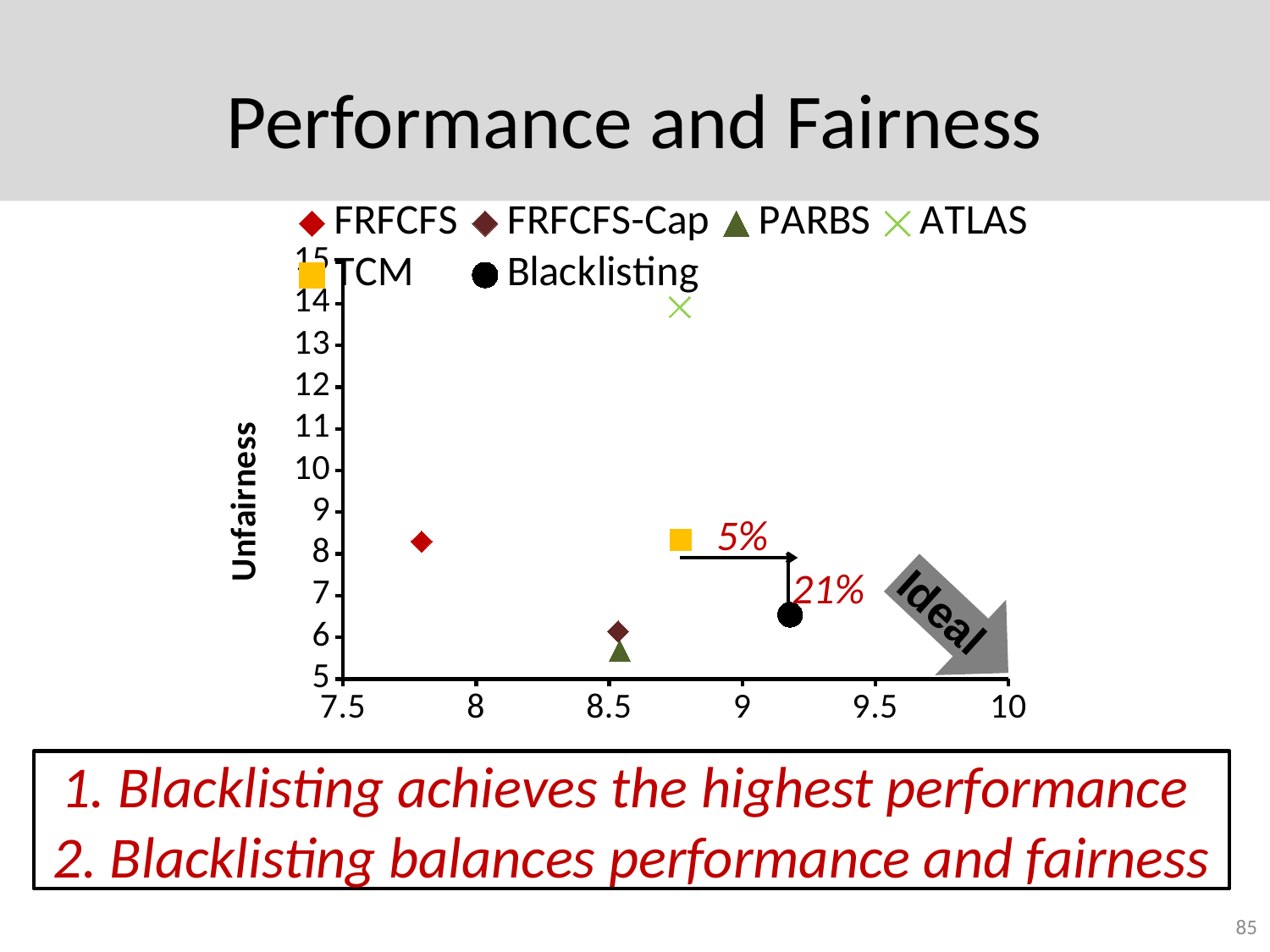
Which series is plotted furthest to the right on the x axis? Blacklisting Which has the higher unfairness value, ATLAS or TCM? ATLAS What is the title of the y axis? Unfairness Is the unfairness value for Blacklisting greater or less than 7? less Which series has the lowest unfairness value? PARBS How many series does the legend list? 6 How many data points are plotted on the chart? 6 Which series has the highest unfairness value? ATLAS Is the x-axis value for Blacklisting greater or less than 9? greater Is the unfairness value for ATLAS greater or less than 13? greater What kind of chart is shown on the slide? scatter chart Which series is plotted furthest to the left on the x axis? FRFCFS